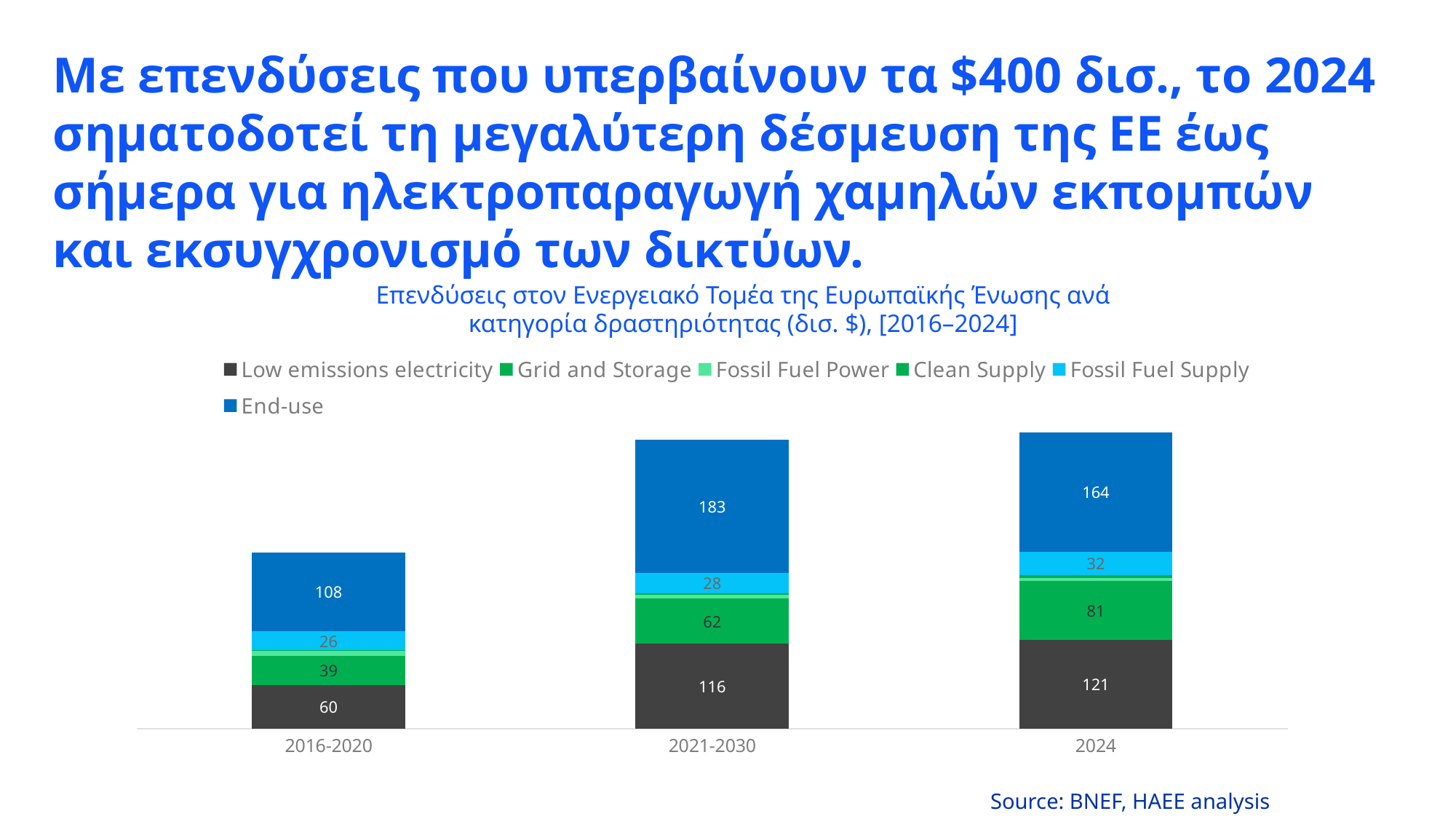
Which period has the larger Low emissions electricity value, 2021-2030 or 2024? 2024 Which period has the highest End-use value? 2021-2030 What is the difference between the End-use values for 2021-2030 and 2024? 19 What is the value of the End-use segment for 2021-2030? 183 Which period has the lowest Low emissions electricity value? 2016-2020 What is the difference between the Fossil Fuel Supply values for 2024 and 2016-2020? 6 What is the value of the Fossil Fuel Supply segment for 2016-2020? 26 What is the value of the Low emissions electricity segment for 2024? 121 What kind of chart is shown on the slide? Stacked bar chart How many periods are shown on the x axis? 3 Do the Low emissions electricity values rise or fall from 2016-2020 to 2024? Rise How many series does the legend list? 6